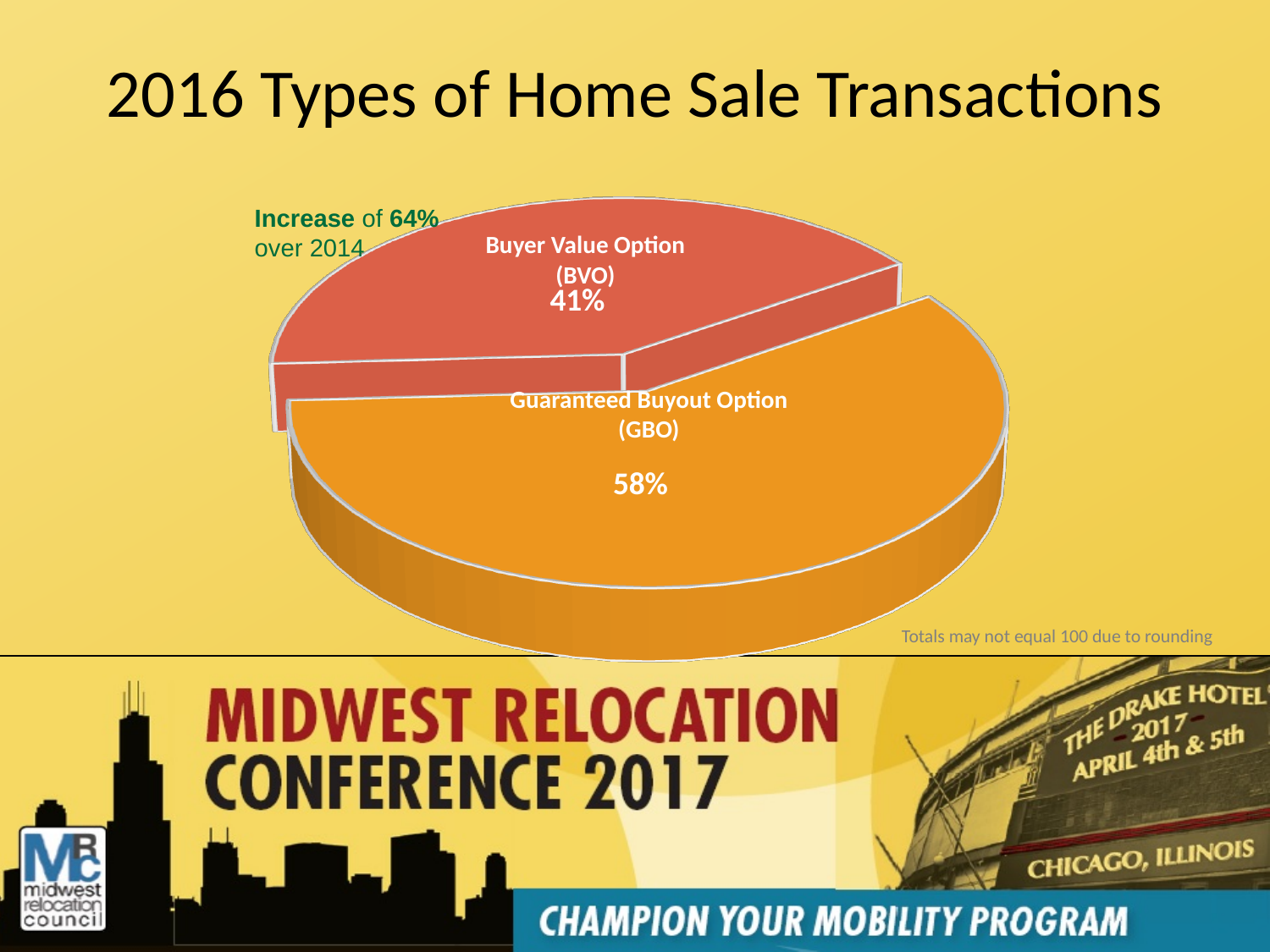
Which is larger, the share for Buyer Value Option (BVO) or the share for Guaranteed Buyout Option (GBO)? Guaranteed Buyout Option (GBO) What kind of chart is shown on the slide? Pie chart What colour is the Guaranteed Buyout Option (GBO) slice? Orange According to the annotation on the chart, by how much did the Buyer Value Option increase over 2014? 64% How many slices does the pie chart have? 2 What percentage of home sale transactions were Buyer Value Option (BVO)? 41% Which type of home sale transaction has the largest share? Guaranteed Buyout Option (GBO) What is the difference in percentage points between the GBO share and the BVO share? 17 Which type of home sale transaction has the smallest share? Buyer Value Option (BVO) What percentage of home sale transactions were Guaranteed Buyout Option (GBO)? 58% What is the title of the slide containing the chart? 2016 Types of Home Sale Transactions